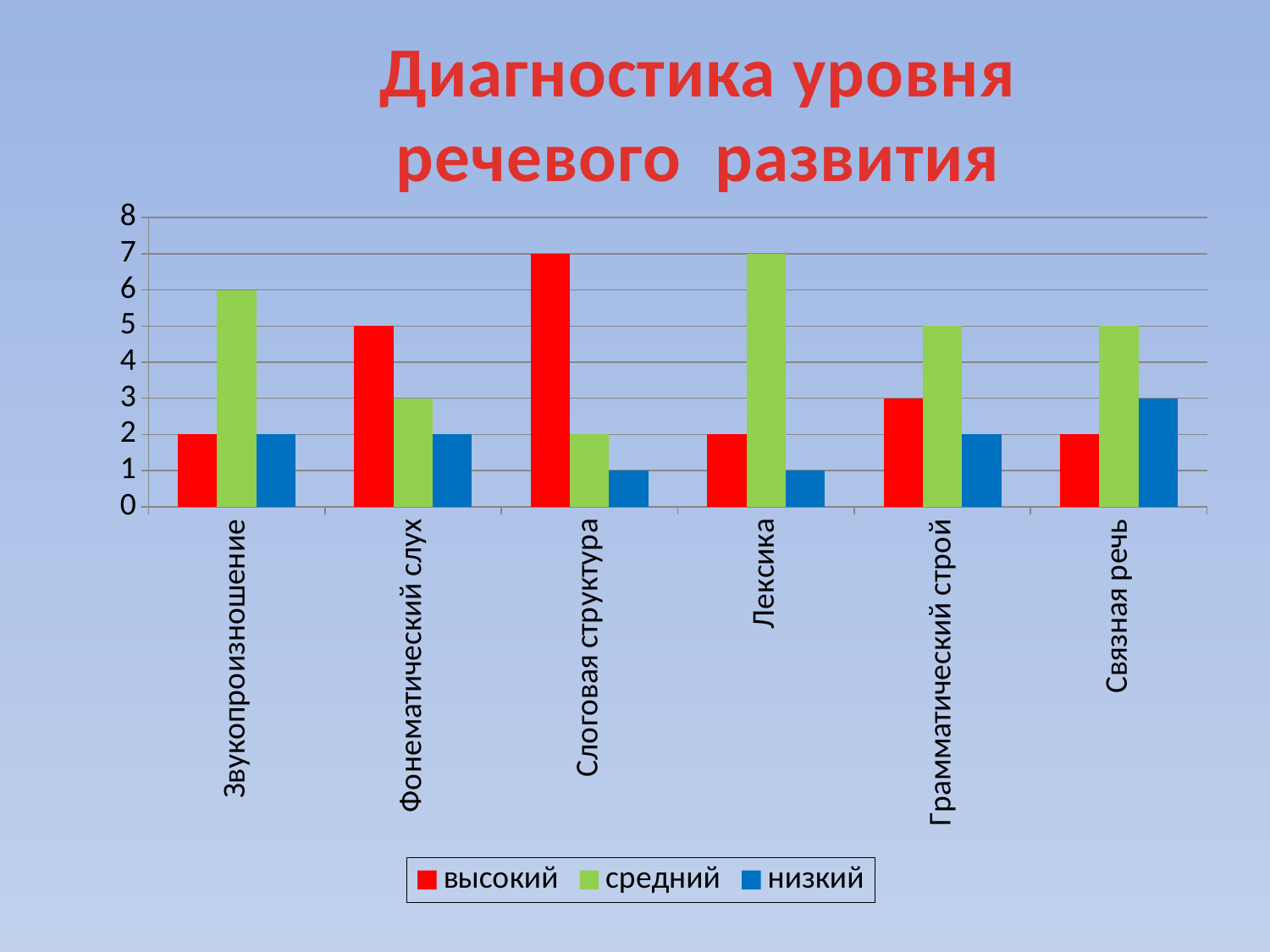
What is the value of the средний series for Звукопроизношение? 6 What is the difference between the высокий and средний values for Фонематический слух? 2 What is the value of the низкий series for Связная речь? 3 What colour represents the низкий series in the legend? blue Is the value of the средний series for Лексика greater or less than 5? greater How many series does the legend list? 3 What is the value of the высокий series for Слоговая структура? 7 What kind of chart is shown on the slide? bar chart Which category has the highest value in the высокий series? Слоговая структура How many categories are shown on the x axis? 6 For Грамматический строй, which is larger: the высокий value or the средний value? средний Which category has the highest value in the средний series? Лексика